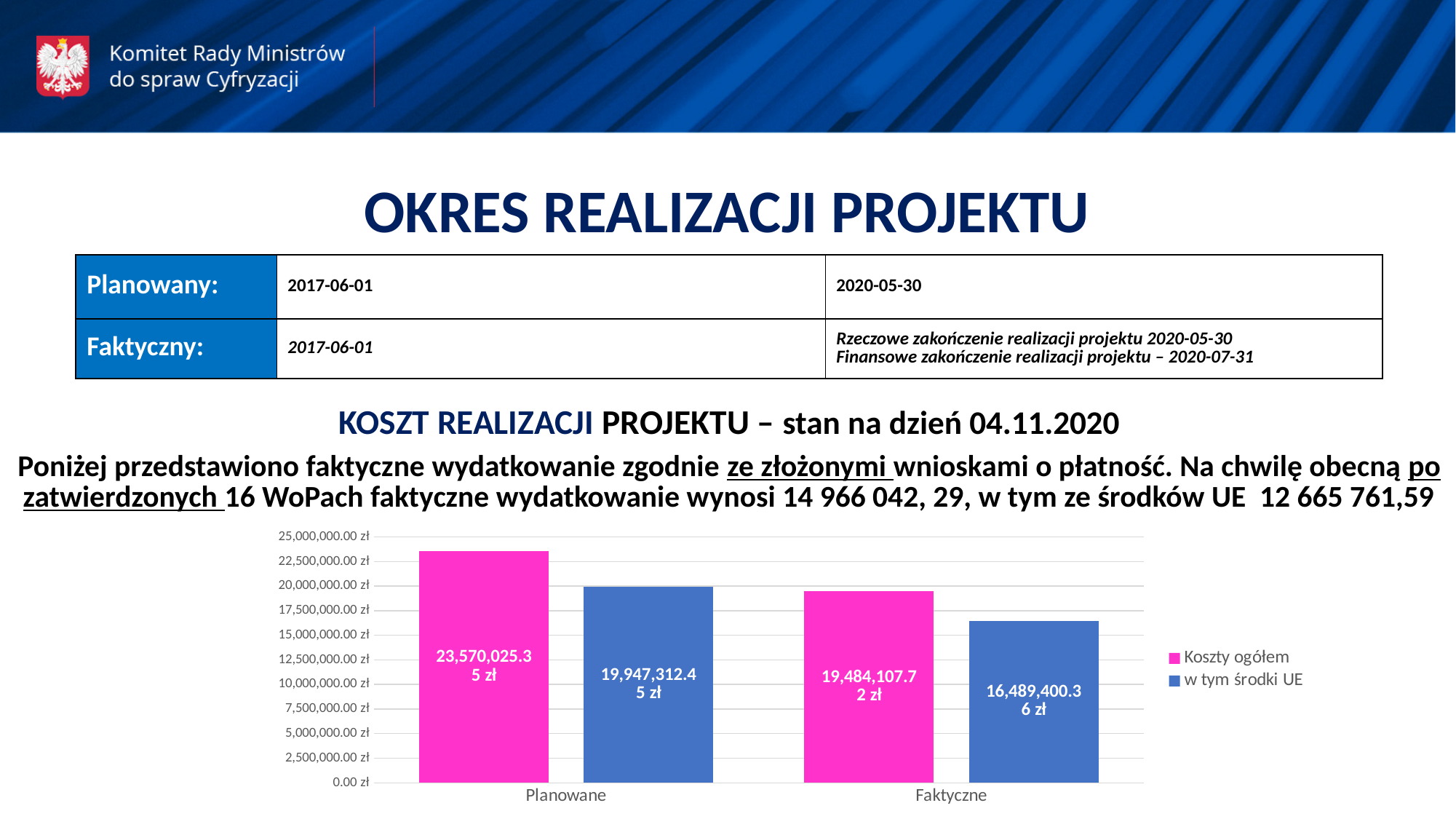
Which bar in the chart has the lowest value? w tym środki UE for Faktyczne What kind of chart is shown on the slide? Bar chart What is the difference between Koszty ogółem for Planowane and Koszty ogółem for Faktyczne? 4,085,917.63 zł Which bar in the chart has the highest value? Koszty ogółem for Planowane How many series does the chart legend list? 2 What colour are the Koszty ogółem bars in the chart? Pink (magenta) What is the value of Koszty ogółem for Faktyczne? 19,484,107.72 zł What is the value of Koszty ogółem for Planowane? 23,570,025.35 zł What is the value of w tym środki UE for Planowane? 19,947,312.45 zł What is the value of w tym środki UE for Faktyczne? 16,489,400.36 zł Which is larger: w tym środki UE for Planowane or Koszty ogółem for Faktyczne? w tym środki UE for Planowane What is the difference between Koszty ogółem and w tym środki UE for Planowane? 3,622,712.90 zł